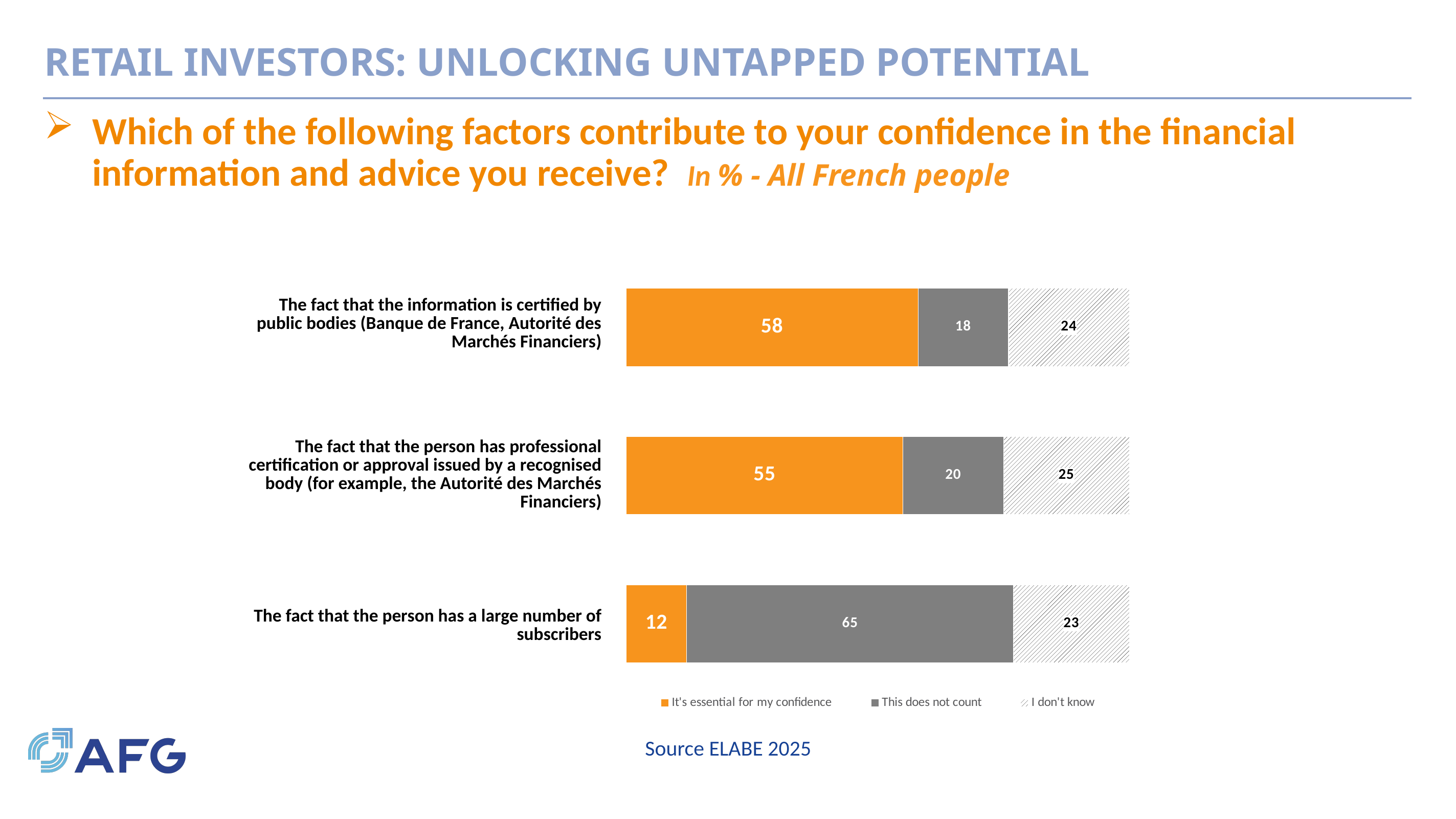
What is the total of the stacked bar for the fact that the person has a large number of subscribers? 100 Which factor has the lowest "It's essential for my confidence" value? The fact that the person has a large number of subscribers Which factor has the highest "It's essential for my confidence" value? The fact that the information is certified by public bodies (Banque de France, Autorité des Marchés Financiers) How many series does the legend list? 3 Which series is shown with a hatched pattern in the legend? I don't know What is the value of "I don't know" for the fact that the person has professional certification or approval issued by a recognised body? 25 What kind of chart is shown on the slide? Stacked bar chart What is the difference between the "It's essential for my confidence" values for the public bodies certification factor and the professional certification factor? 3 Which is larger: the "This does not count" value for the professional certification factor or for the large number of subscribers factor? The fact that the person has a large number of subscribers How many factors (categories) are plotted in the chart? 3 What is the value of "It's essential for my confidence" for the fact that the information is certified by public bodies? 58 What is the value of "This does not count" for the fact that the person has a large number of subscribers? 65